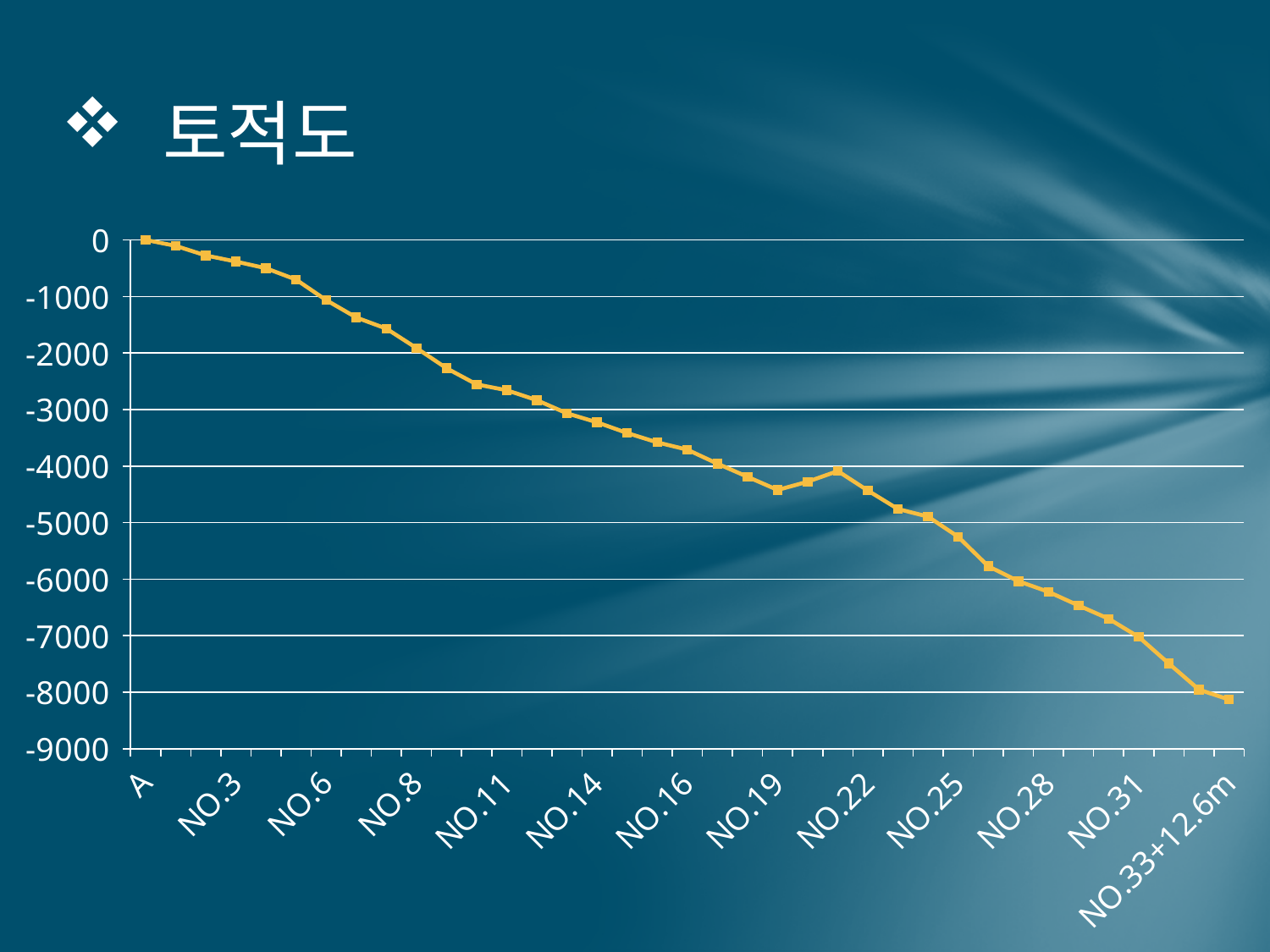
Which category has the lowest plotted value? NO.33+12.6m Is the value for NO.3 greater or less than -1000? greater What kind of chart is shown on the slide? line chart Do the plotted values generally rise or fall from A to NO.33+12.6m? fall What is the lowest value labelled on the vertical axis? -9000 What is the value plotted at A? 0 Which has the larger value, NO.6 or NO.28? NO.6 Is the value for NO.19 greater or less than -4000? less Is the value for NO.8 greater or less than -1000? less Which category has the highest plotted value? A What is the title of the chart? 토적도